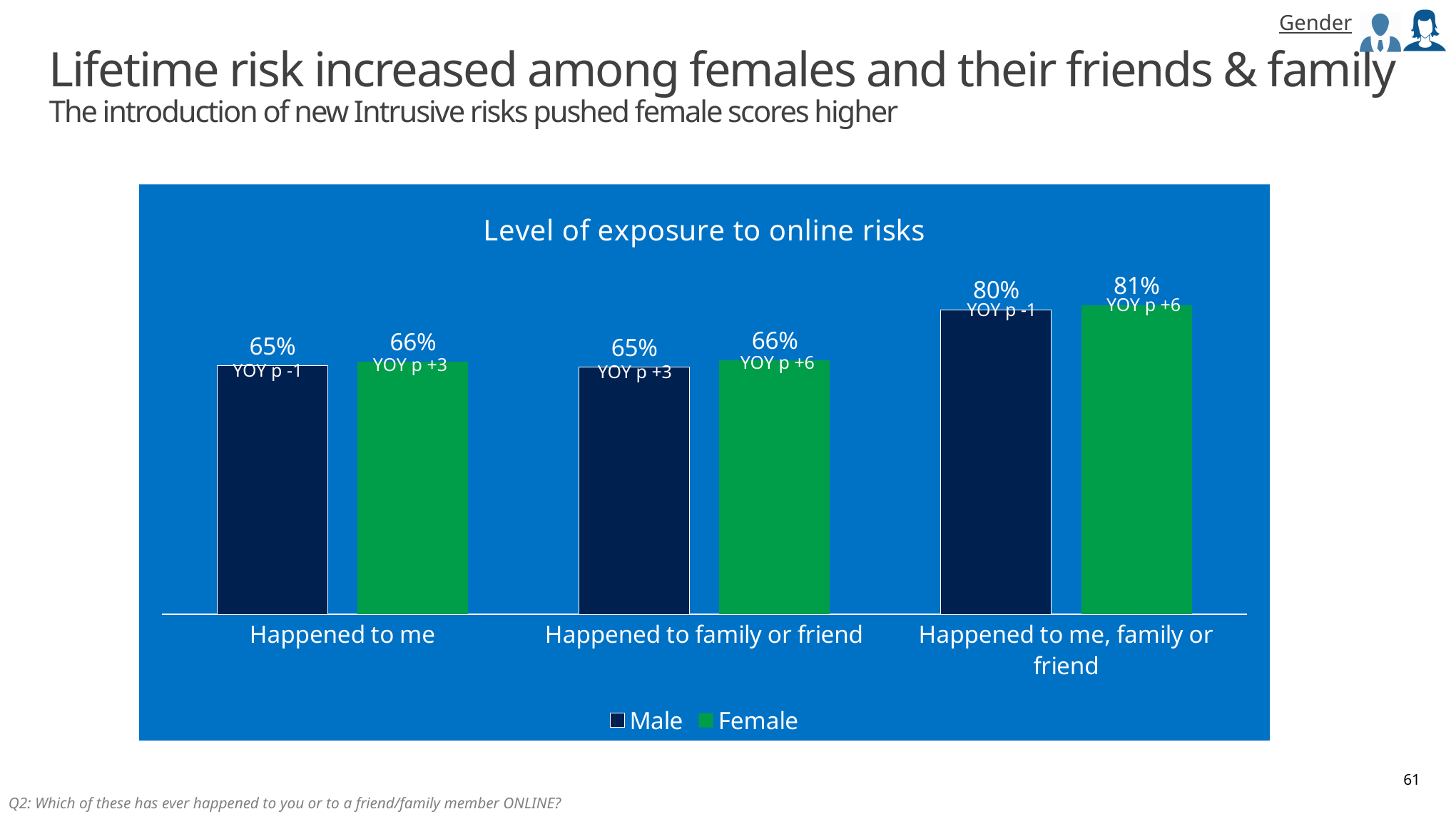
What is the Female value for "Happened to family or friend"? 66% How many series does the legend list? 2 What is the title of the chart? Level of exposure to online risks Which is larger: the Male value for "Happened to me, family or friend" or the Male value for "Happened to family or friend"? Happened to me, family or friend What is the difference between the Female and Male values for "Happened to me, family or friend"? 1% What is the Male value for "Happened to me"? 65% What is the difference between the Male values for "Happened to me, family or friend" and "Happened to me"? 15% Which category has the highest Female value? Happened to me, family or friend What kind of chart is shown? Bar chart What is the Female value for "Happened to me, family or friend"? 81% What is the Male value for "Happened to me, family or friend"? 80% How many categories are shown on the x axis? 3